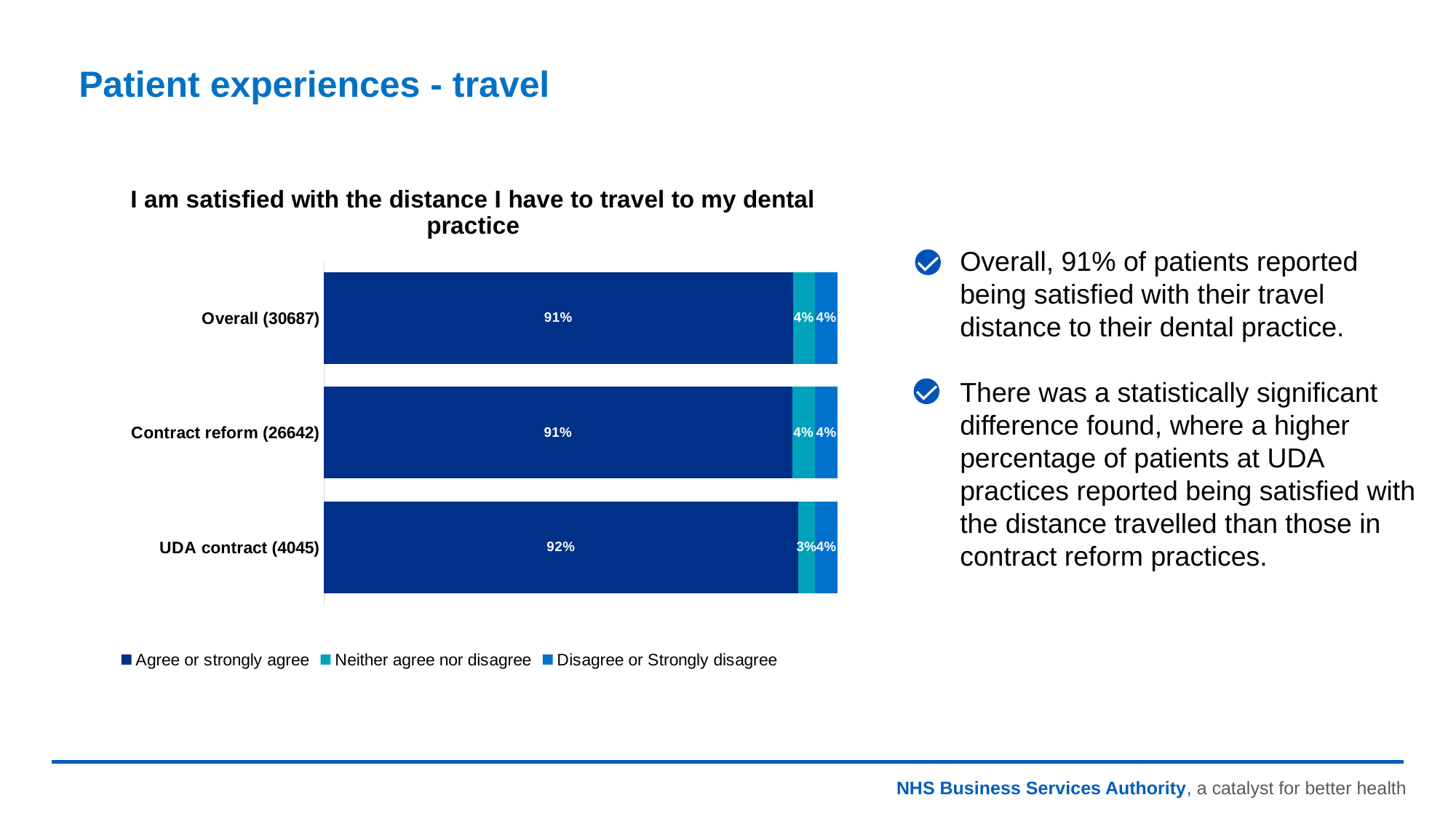
What type of chart is shown on the slide? Stacked bar chart How many groups (bars) are shown in the chart? 3 How many series does the legend list? 3 What percentage of patients in the UDA contract (4045) group disagree or strongly disagree? 4% What percentage of patients in the UDA contract (4045) group neither agree nor disagree? 3% What is the difference in the 'Agree or strongly agree' percentage between the UDA contract (4045) group and the Contract reform (26642) group? 1% What percentage of patients in the Overall (30687) group agree or strongly agree that they are satisfied with the distance they have to travel to their dental practice? 91% What percentage of patients in the Contract reform (26642) group neither agree nor disagree? 4% Which group has the highest percentage of patients who agree or strongly agree? UDA contract (4045) Which is larger: the 'Neither agree nor disagree' percentage for Contract reform (26642) or for UDA contract (4045)? Contract reform (26642) What is the title of the chart? I am satisfied with the distance I have to travel to my dental practice What percentage of patients in the UDA contract (4045) group agree or strongly agree? 92%